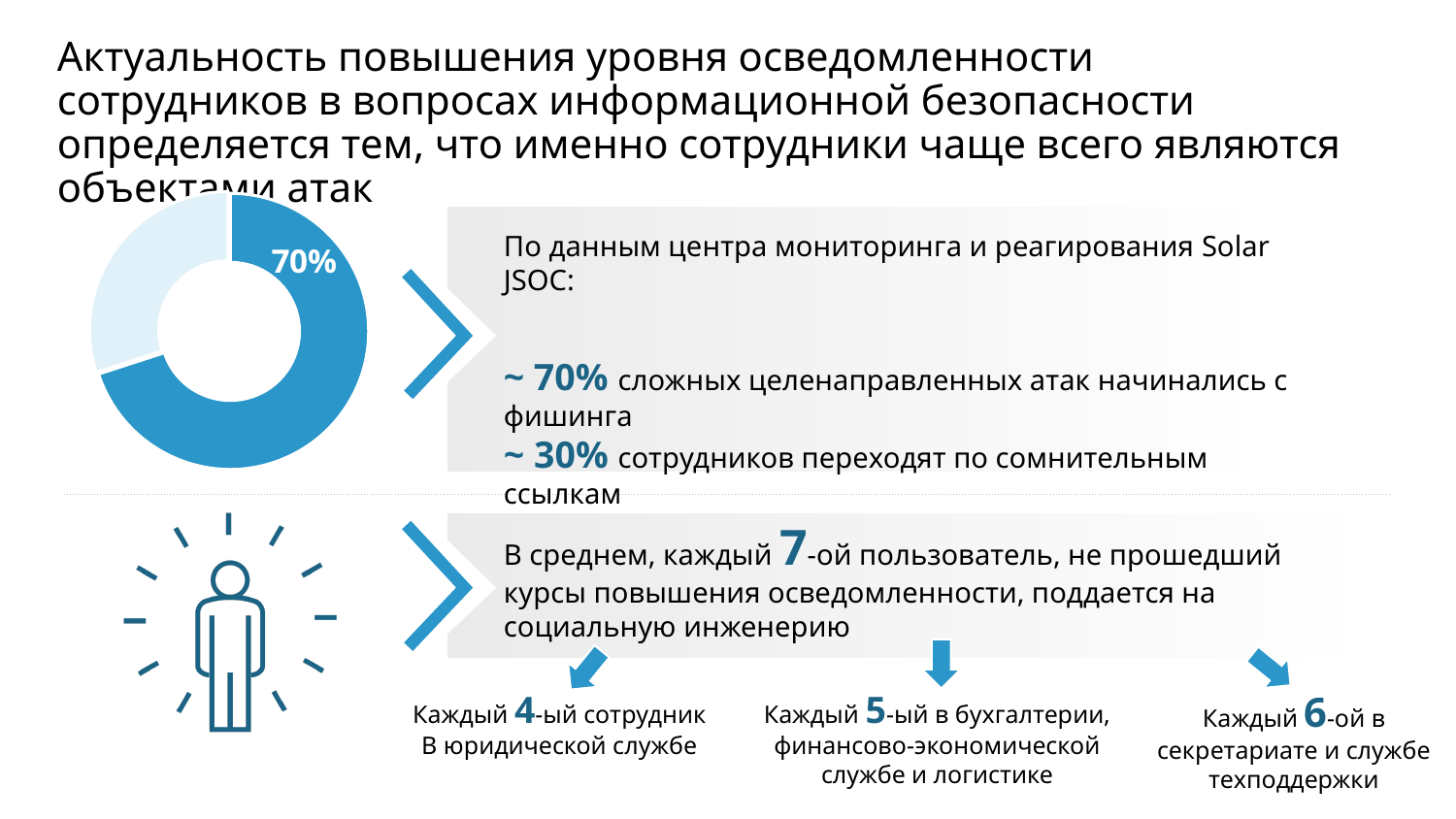
Which slice of the donut chart is larger, the dark blue one or the light blue one? The dark blue one What kind of chart is shown on the left of the slide? Donut (pie) chart Is the labelled slice of the donut chart greater or less than 50%? greater What value is printed on the large dark blue slice of the donut chart? 70% How many slices does the donut chart have? 2 What colour is the slice of the donut chart labelled 70%? Dark blue Does the donut chart show any data label other than 70%? No